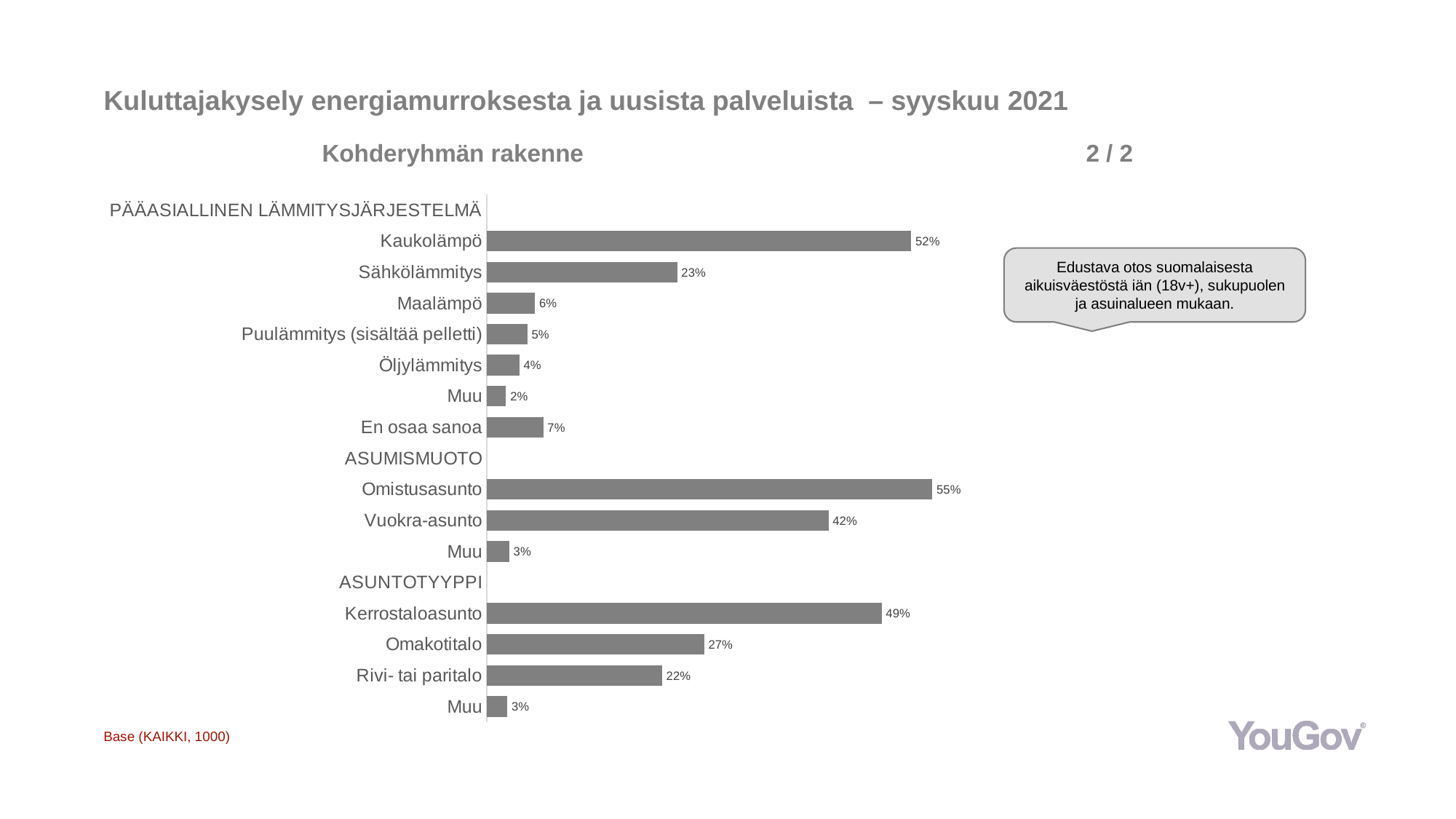
Which category under ASUNTOTYYPPI has the highest value? Kerrostaloasunto What is the value for Kaukolämpö? 52% What kind of chart is shown on the slide? Bar chart Which category under PÄÄASIALLINEN LÄMMITYSJÄRJESTELMÄ has the lowest value? Muu What is the difference between Kerrostaloasunto and Omakotitalo? 22 percentage points What is the difference between Omistusasunto and Vuokra-asunto? 13 percentage points What is the value for En osaa sanoa under PÄÄASIALLINEN LÄMMITYSJÄRJESTELMÄ? 7% How many bars are shown under ASUMISMUOTO? 3 Which category under PÄÄASIALLINEN LÄMMITYSJÄRJESTELMÄ has the highest value? Kaukolämpö What is the value for Vuokra-asunto? 42% Which is larger, Sähkölämmitys or Omakotitalo? Omakotitalo What is the value for Rivi- tai paritalo? 22%